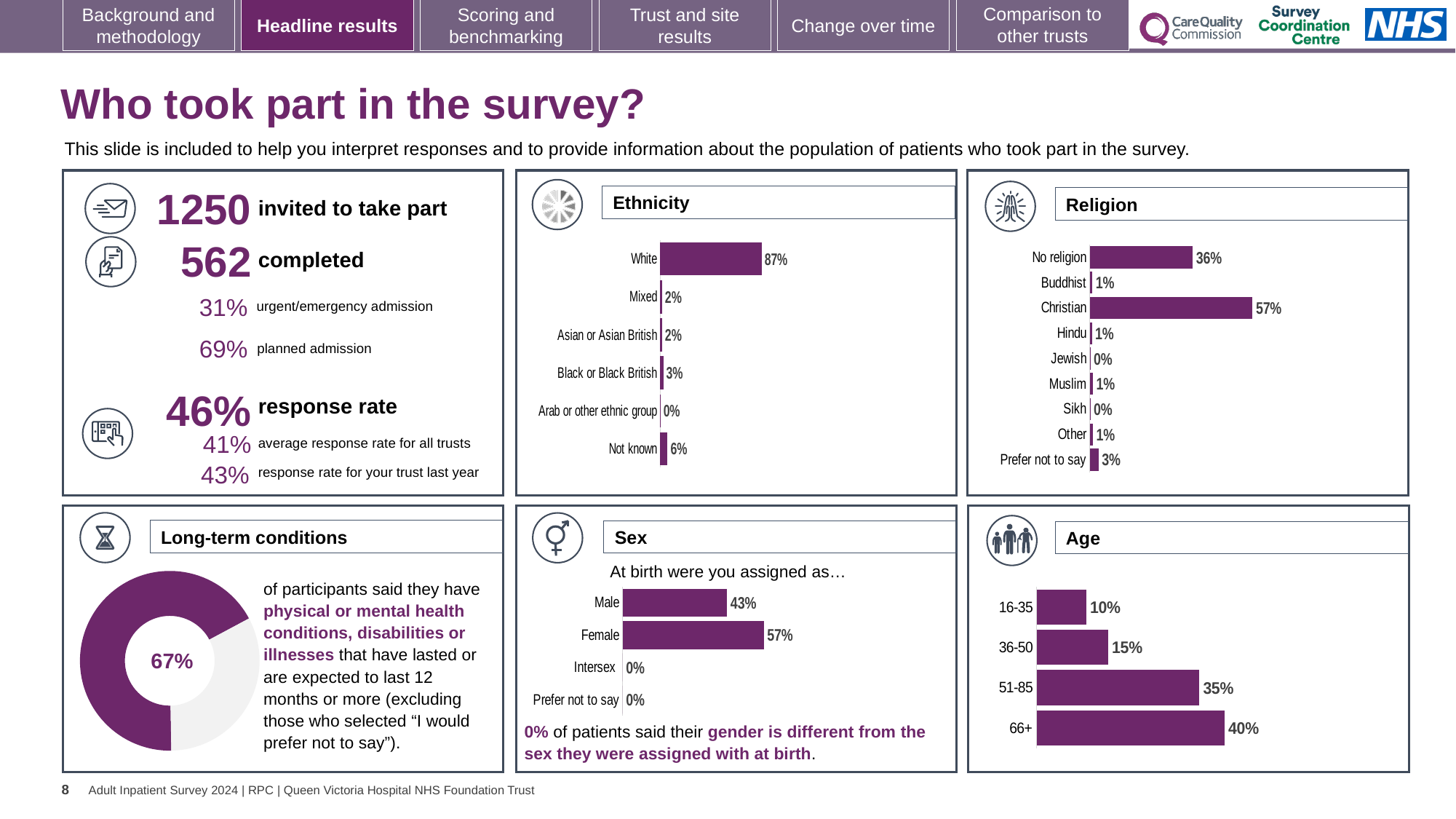
In the Ethnicity chart, what percentage of respondents are White? 87% In the Sex chart, what is the difference between Female and Male? 14% In the Religion chart, what is the difference between Christian and No religion? 21% In the Religion chart, which category has the highest value? Christian What kind of chart is the Long-term conditions chart? doughnut chart In the Religion chart, how many categories are shown? 9 In the Age chart, what percentage of respondents are aged 66+? 40% In the Ethnicity chart, what percentage of respondents are Not known? 6% In the Age chart, which age group has the lowest value? 16-35 In the Age chart, do the values rise or fall as you move from the 16-35 group to the 66+ group? rise In the Sex chart, which is larger, Male or Female? Female In the Religion chart, what percentage of respondents have No religion? 36%